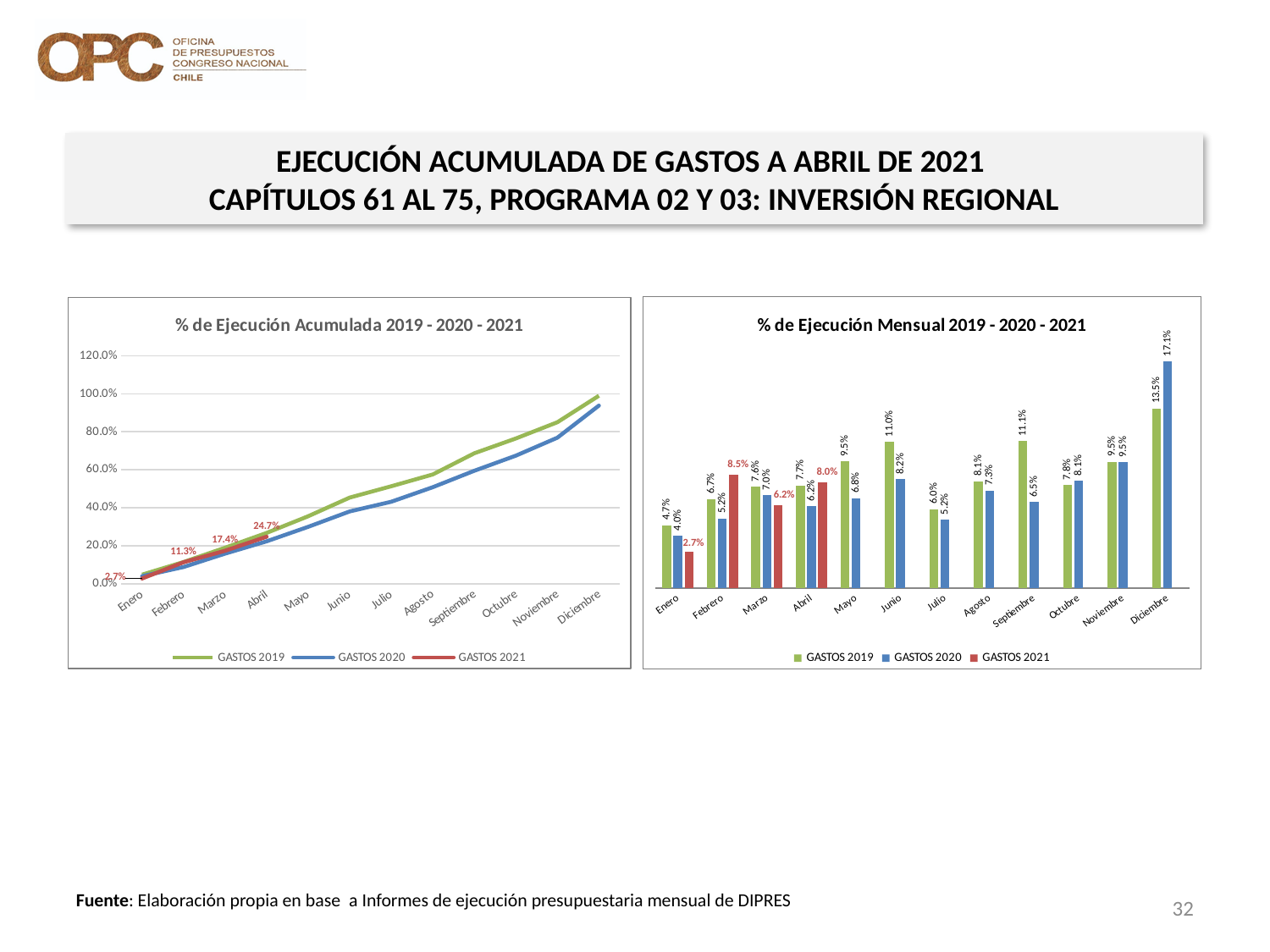
In the left chart '% de Ejecución Acumulada', what is the GASTOS 2021 value for Abril? 24.7% In the right chart '% de Ejecución Mensual', which month has the lowest GASTOS 2021 value? Enero In the left chart '% de Ejecución Acumulada', what is the GASTOS 2021 value for Febrero? 11.3% What kind of chart is the left chart, '% de Ejecución Acumulada 2019 - 2020 - 2021'? Line chart In the right chart '% de Ejecución Mensual', what is the GASTOS 2021 value for Febrero? 8.5% In the right chart '% de Ejecución Mensual', which is larger for Septiembre: GASTOS 2019 or GASTOS 2020? GASTOS 2019 In the right chart '% de Ejecución Mensual', which month has the highest GASTOS 2019 value? Diciembre What kind of chart is the right chart, '% de Ejecución Mensual 2019 - 2020 - 2021'? Bar chart In the right chart '% de Ejecución Mensual', what is the difference between the GASTOS 2020 and GASTOS 2019 values for Diciembre? 3.6% How many series does the legend of the right chart '% de Ejecución Mensual' list? 3 In the right chart '% de Ejecución Mensual', what is the GASTOS 2020 value for Diciembre? 17.1% In the left chart '% de Ejecución Acumulada', is the GASTOS 2019 value for Diciembre greater or less than 80.0%? greater